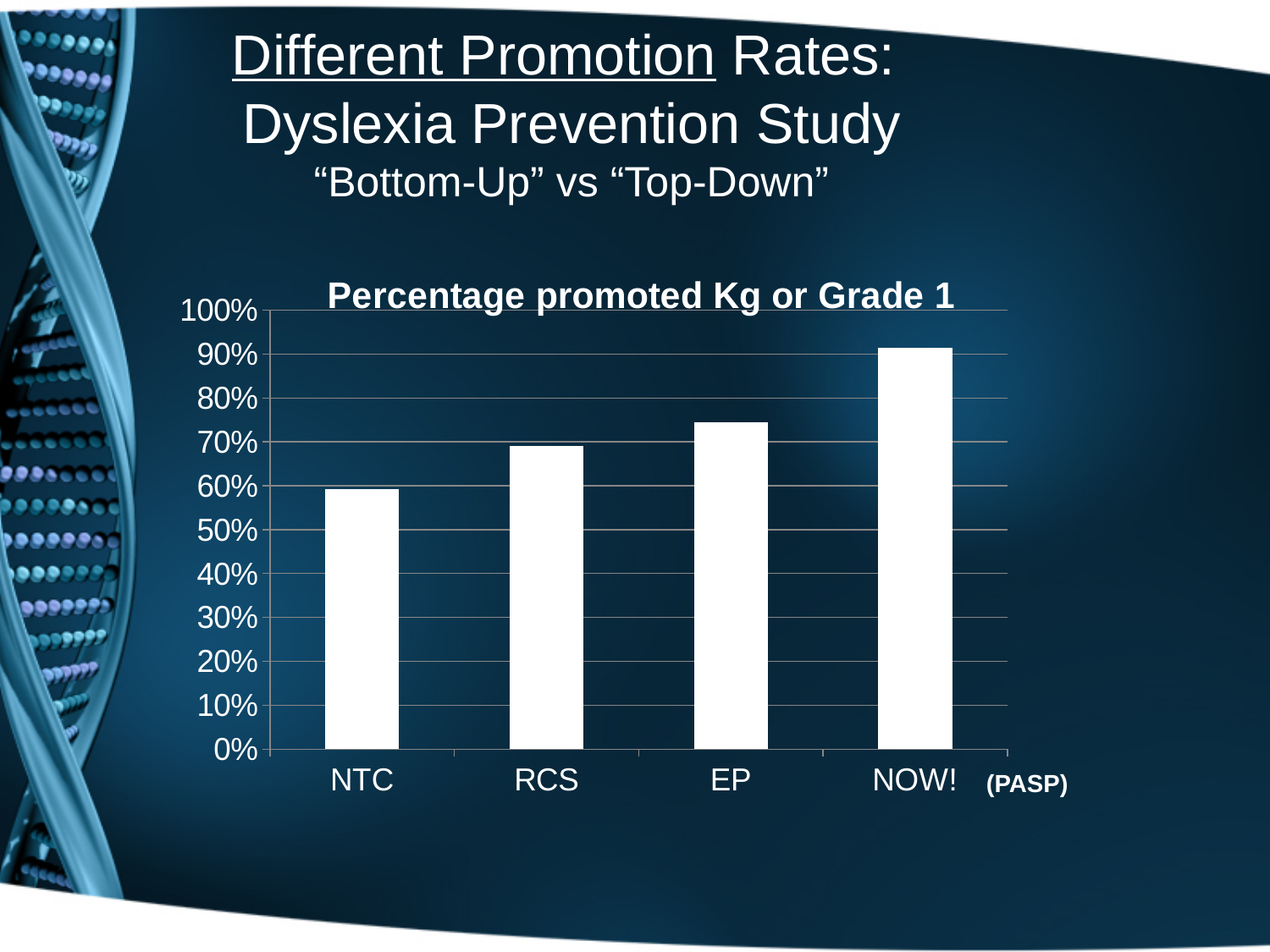
Which category has the lowest percentage promoted? NTC Is the value for NTC greater or less than 50%? greater Which has a higher percentage promoted, NTC or NOW!? NOW! Which category has the highest percentage promoted? NOW! Is the value for EP greater or less than 80%? less Is the value for NOW! greater or less than 80%? greater Do the values rise or fall moving from NTC to NOW! along the x axis? rise Which has a higher percentage promoted, RCS or EP? EP How many categories are shown on the x axis of the chart? 4 What kind of chart is shown on the slide? bar chart What is the title of the chart? Percentage promoted Kg or Grade 1